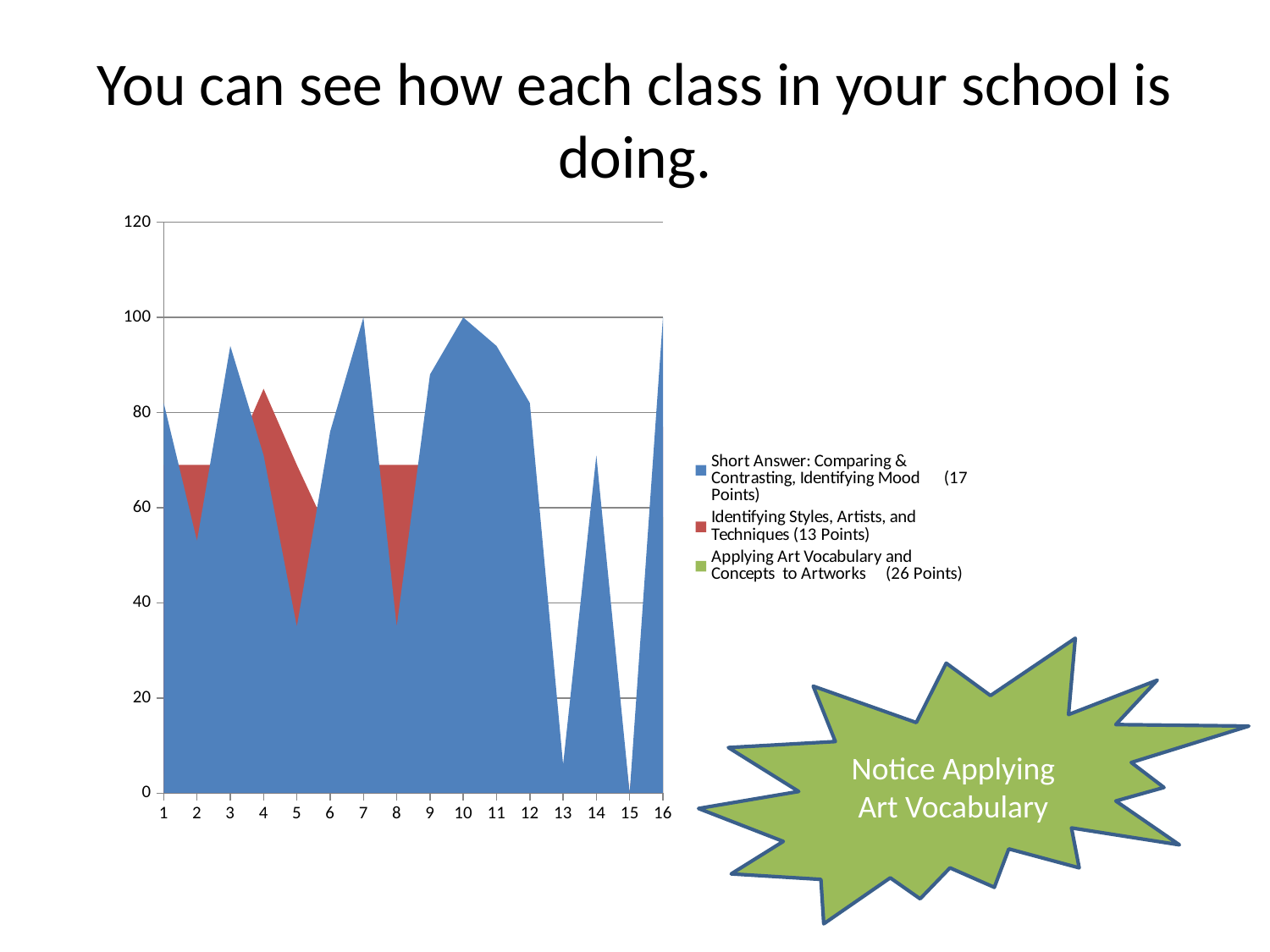
Is the value for category 5 in the Short Answer: Comparing & Contrasting, Identifying Mood series greater or less than 40? less What kind of chart is shown on the slide? Area chart How many categories are shown along the x axis of the chart? 16 Which has the larger value in the Short Answer: Comparing & Contrasting, Identifying Mood series, category 3 or category 2? Category 3 Is the value for category 13 in the Short Answer: Comparing & Contrasting, Identifying Mood series greater or less than 20? less How many points is the Applying Art Vocabulary and Concepts to Artworks series worth, according to the legend? 26 Points Which series is shown in red in the chart's legend? Identifying Styles, Artists, and Techniques (13 Points) Is the value for category 2 in the Short Answer: Comparing & Contrasting, Identifying Mood series greater or less than 60? less Which category has the lowest value for the Short Answer: Comparing & Contrasting, Identifying Mood series? 15 How many series does the chart's legend list? 3